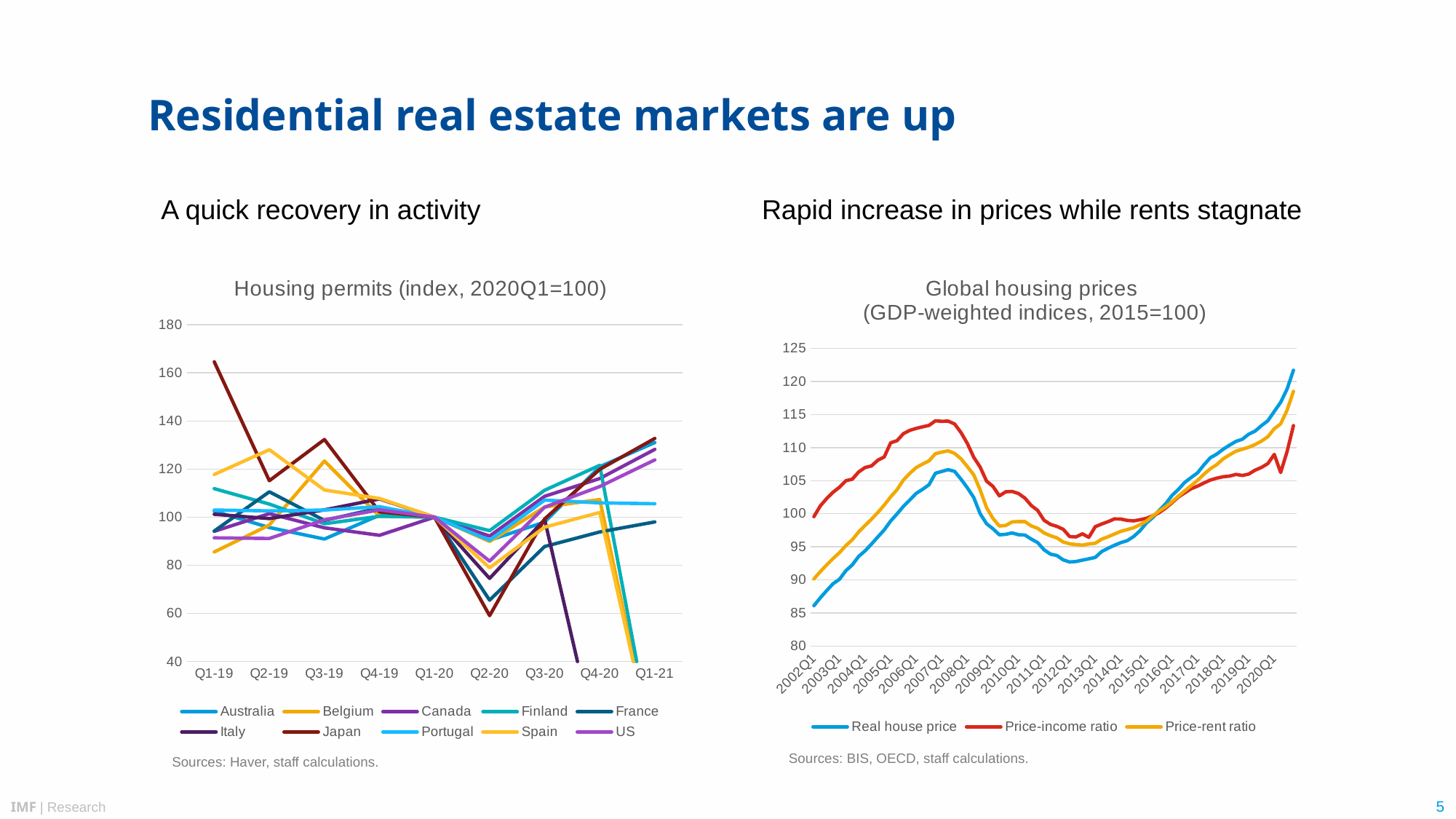
In the 'Housing permits' chart on the left, is the value for Japan at Q2-20 greater or less than 80? less In the 'Housing permits' chart on the left, which is higher at Q1-19: Japan or Spain? Japan In the 'Housing permits' chart on the left, which series has the lowest value at Q2-20? Japan In the 'Housing permits' chart on the left, what is the index value of all series at Q1-20? 100 How many series does the legend of the 'Housing permits' chart on the left list? 10 In the 'Global housing prices' chart on the right, which is higher at 2007Q1: Price-income ratio or Real house price? Price-income ratio In the 'Housing permits' chart on the left, is the value for Japan at Q1-19 greater or less than 140? greater How many quarters are shown on the x axis of the 'Housing permits' chart on the left? 9 How many series does the legend of the 'Global housing prices' chart on the right list? 3 What kind of chart is the 'Housing permits (index, 2020Q1=100)' chart on the left? line chart In the 'Global housing prices' chart on the right, is the Real house price value at 2002Q1 greater or less than 90? less In the 'Global housing prices' chart on the right, does the Real house price series rise or fall from 2016Q1 to the end of the series? rise